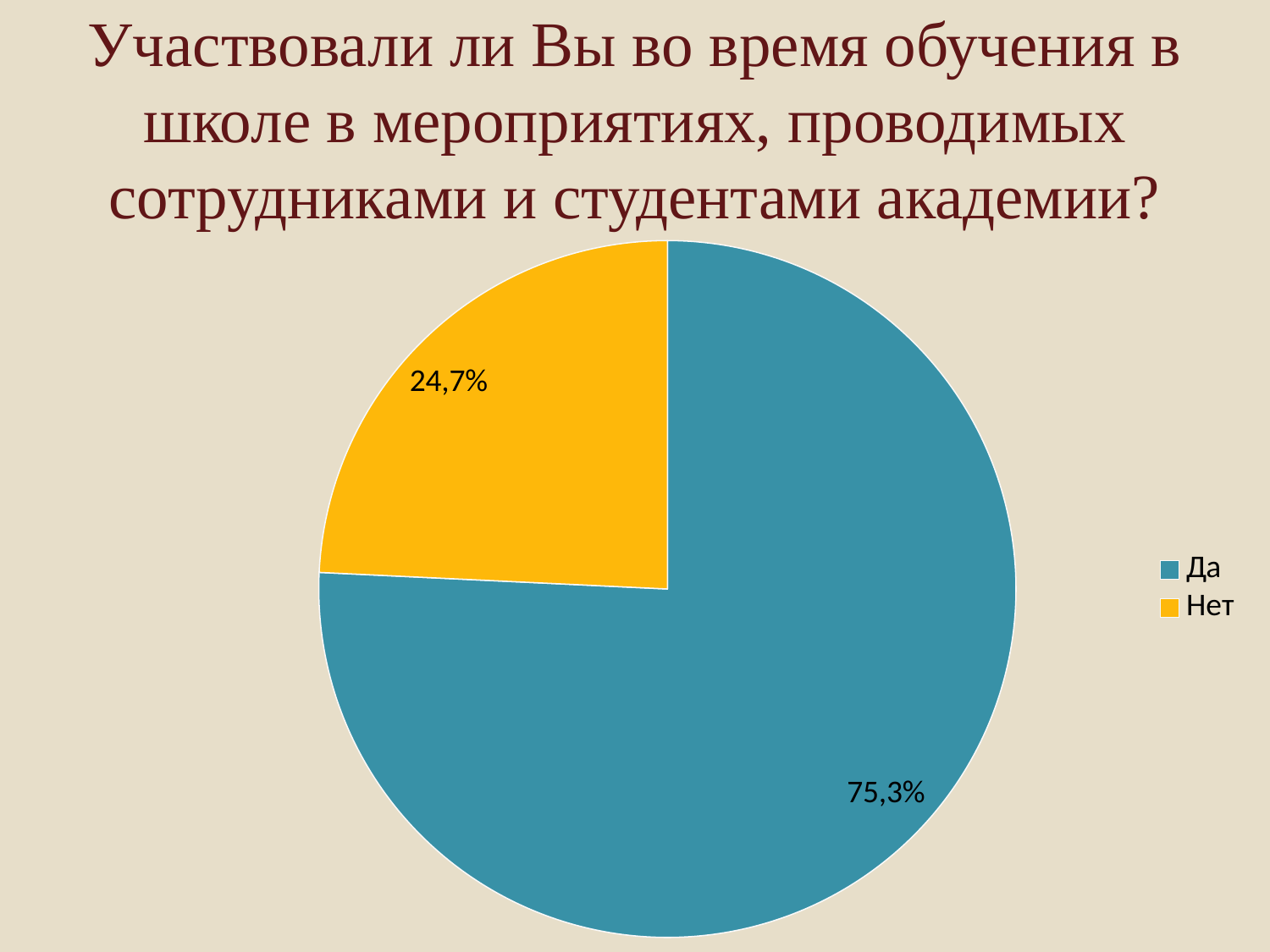
How many slices does the pie chart have? 2 Which slice is larger, "Да" or "Нет"? Да What colour is the "Нет" slice? Yellow Which category has the smallest slice of the pie? Нет What share of the pie does the "Нет" slice represent? 24,7% What is the difference in percentage points between the "Да" and "Нет" slices? 50,6 How many entries does the legend list? 2 What share of the pie does the "Да" slice represent? 75,3% Which category has the largest slice of the pie? Да What colour is the "Да" slice? Blue What kind of chart is shown on the slide? Pie chart